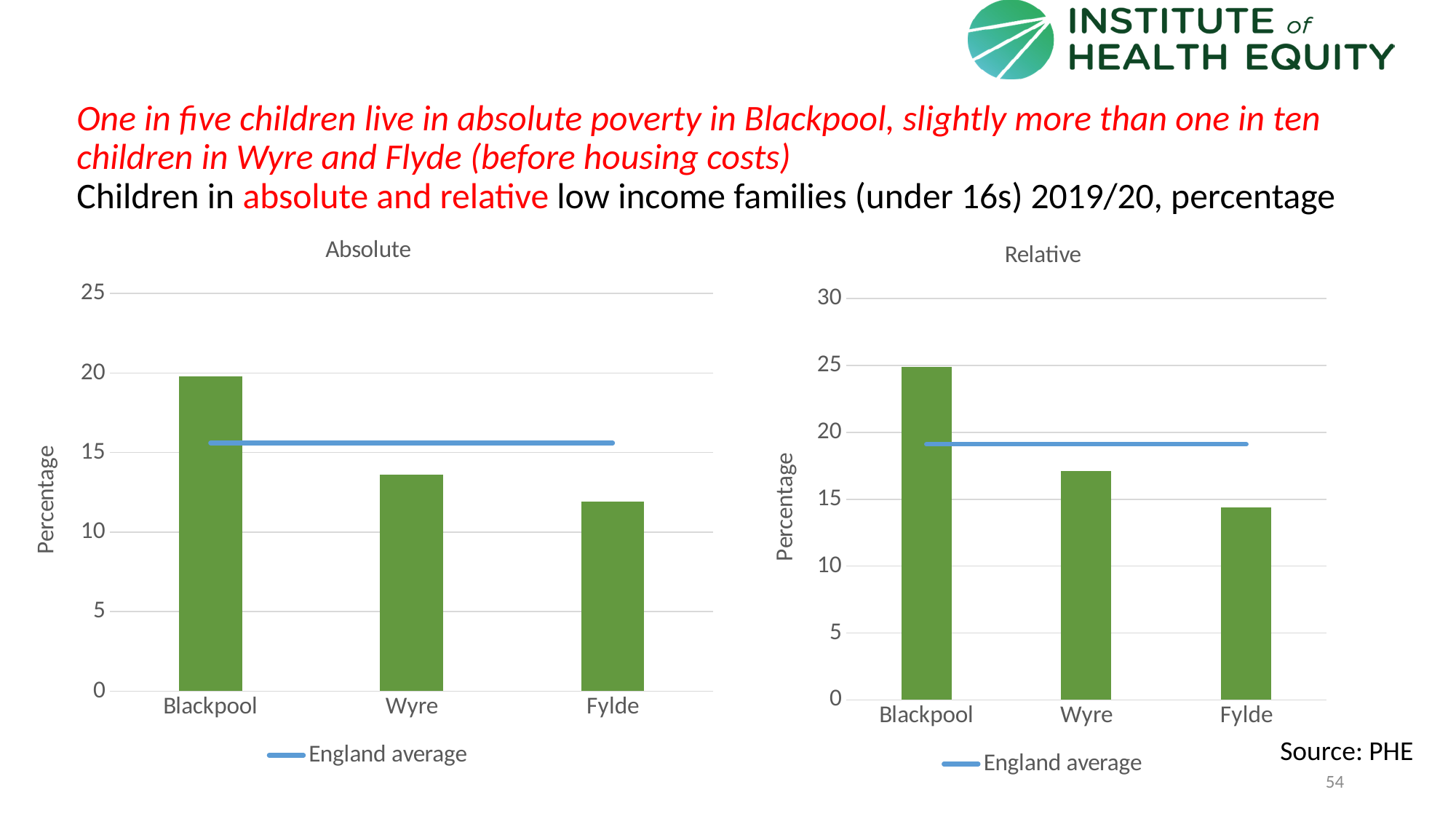
In the Absolute chart, what kind of chart is used to show the values for Blackpool, Wyre and Fylde? bar chart How many areas are shown on the x axis of the Absolute chart? 3 In the Absolute chart, do the bar values rise or fall from Blackpool to Fylde? fall In the Absolute chart, is the value for Blackpool greater or less than 15? greater In the Relative chart, which area has the lowest percentage? Fylde In the Relative chart, is the value for Wyre greater or less than 20? less In the Absolute chart, which area has the lowest percentage? Fylde In the Absolute chart, which area has the highest percentage? Blackpool In the Relative chart, which area has the highest percentage? Blackpool In the Relative chart, which is larger, the value for Wyre or the value for Fylde? Wyre In the Absolute chart, is the value for Fylde greater or less than 15? less